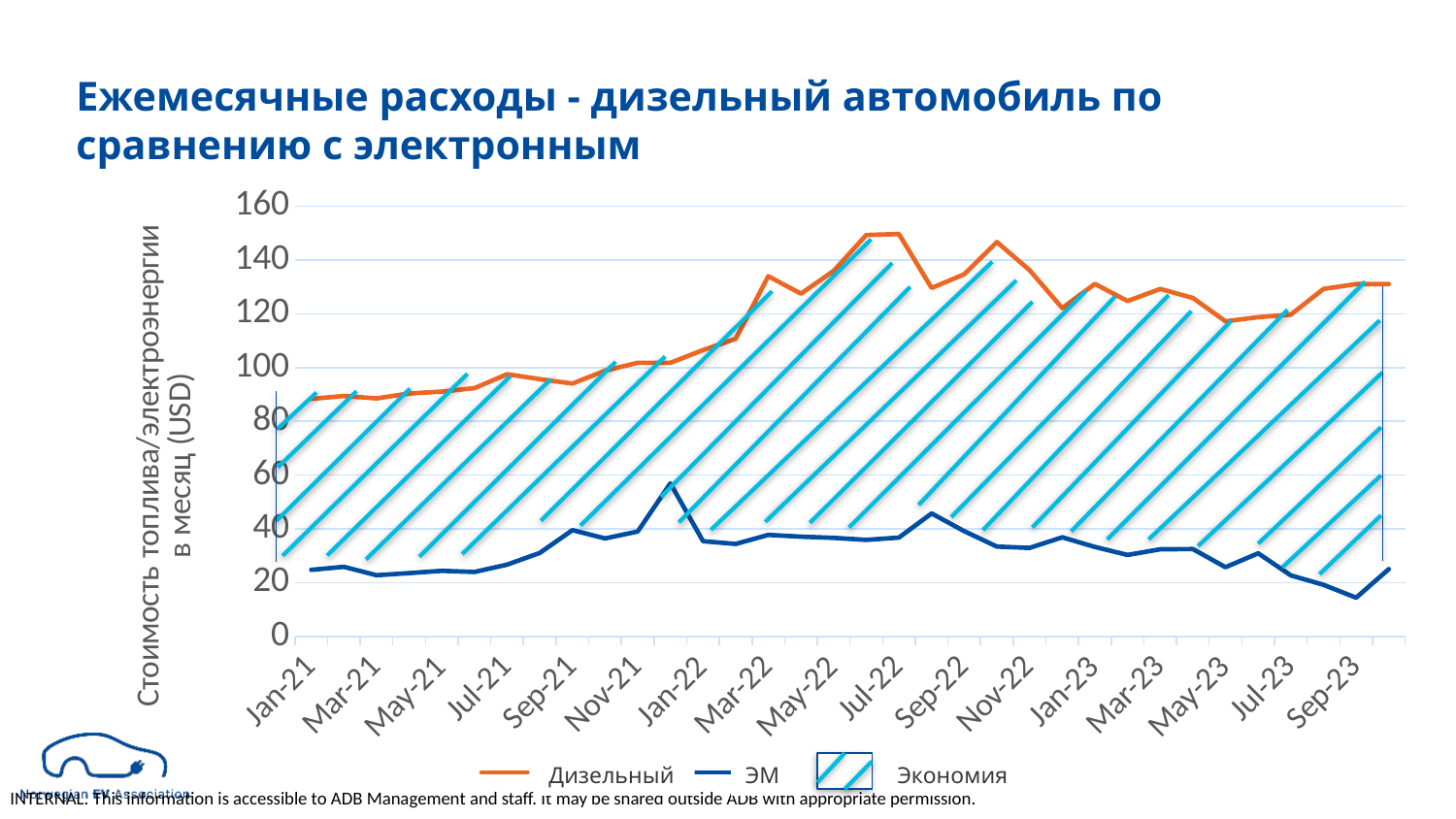
Is the value of the ЭМ series in Jan-22 greater or less than 40? less Does the Дизельный series generally rise or fall from Jan-21 to Jul-22? rise In which month does the ЭМ series reach its highest value? Dec-21 Is the value of the Дизельный series in Sep-23 greater or less than 120? greater Which series has the higher value in Jan-22, Дизельный or ЭМ? Дизельный What is the title of the vertical axis? Стоимость топлива/электроэнергии в месяц (USD) Is the value of the Дизельный series in Jul-22 greater or less than 140? greater In which month does the ЭМ series reach its lowest value? Sep-23 What kind of chart is shown on the slide? line chart How many entries does the chart legend list? 3